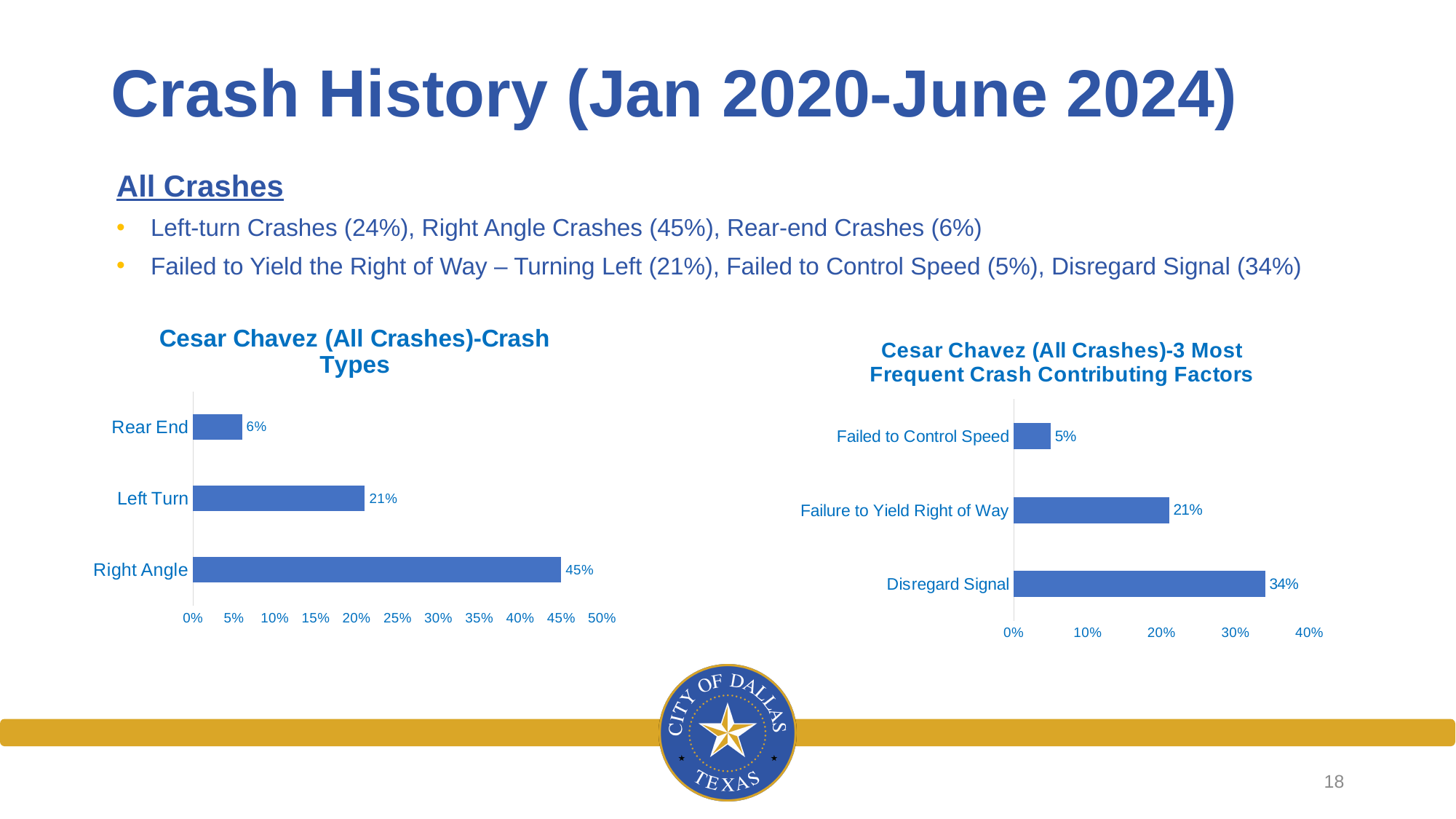
In the 'Cesar Chavez (All Crashes)-3 Most Frequent Crash Contributing Factors' chart, which is larger: Failure to Yield Right of Way or Failed to Control Speed? Failure to Yield Right of Way In the 'Cesar Chavez (All Crashes)-3 Most Frequent Crash Contributing Factors' chart, what is the value for Failed to Control Speed? 5% In the 'Cesar Chavez (All Crashes)-Crash Types' chart, what is the value for Left Turn? 21% In the 'Cesar Chavez (All Crashes)-3 Most Frequent Crash Contributing Factors' chart, what is the highest value shown on the x axis? 40% In the 'Cesar Chavez (All Crashes)-3 Most Frequent Crash Contributing Factors' chart, which factor has the highest value? Disregard Signal In the 'Cesar Chavez (All Crashes)-Crash Types' chart, which crash type has the lowest value? Rear End In the 'Cesar Chavez (All Crashes)-Crash Types' chart, what is the value for Right Angle? 45% In the 'Cesar Chavez (All Crashes)-3 Most Frequent Crash Contributing Factors' chart, what is the value for Disregard Signal? 34% In the 'Cesar Chavez (All Crashes)-3 Most Frequent Crash Contributing Factors' chart, what is the difference between Disregard Signal and Failure to Yield Right of Way? 13% In the 'Cesar Chavez (All Crashes)-Crash Types' chart, how many crash types are shown? 3 In the 'Cesar Chavez (All Crashes)-Crash Types' chart, what is the difference between Right Angle and Left Turn? 24% What kind of chart is the 'Cesar Chavez (All Crashes)-Crash Types' chart? Bar chart